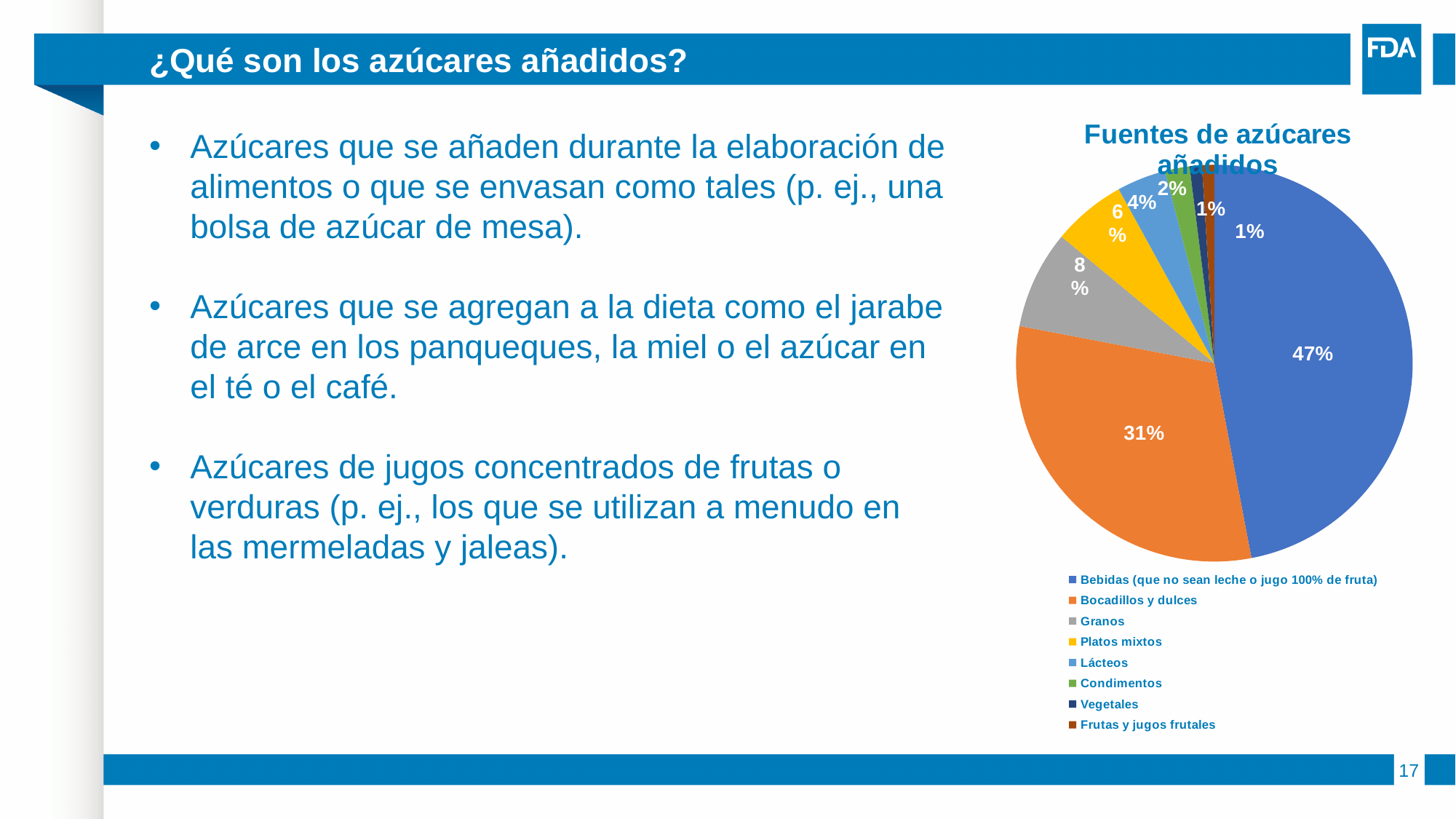
What share of added sugars comes from Granos? 8% What share of added sugars comes from Bebidas (que no sean leche o jugo 100% de fruta)? 47% What share of added sugars comes from Platos mixtos? 6% What share of added sugars comes from Bocadillos y dulces? 31% How many categories does the pie chart show? 8 What is the title of the chart? Fuentes de azúcares añadidos Which has a larger share, Granos or Platos mixtos? Granos Which category has the largest share of added sugars? Bebidas (que no sean leche o jugo 100% de fruta) What share of added sugars comes from Condimentos? 2% What share of added sugars comes from Lácteos? 4% What kind of chart is shown on the slide? Pie chart What is the difference in share between Bebidas and Bocadillos y dulces? 16%